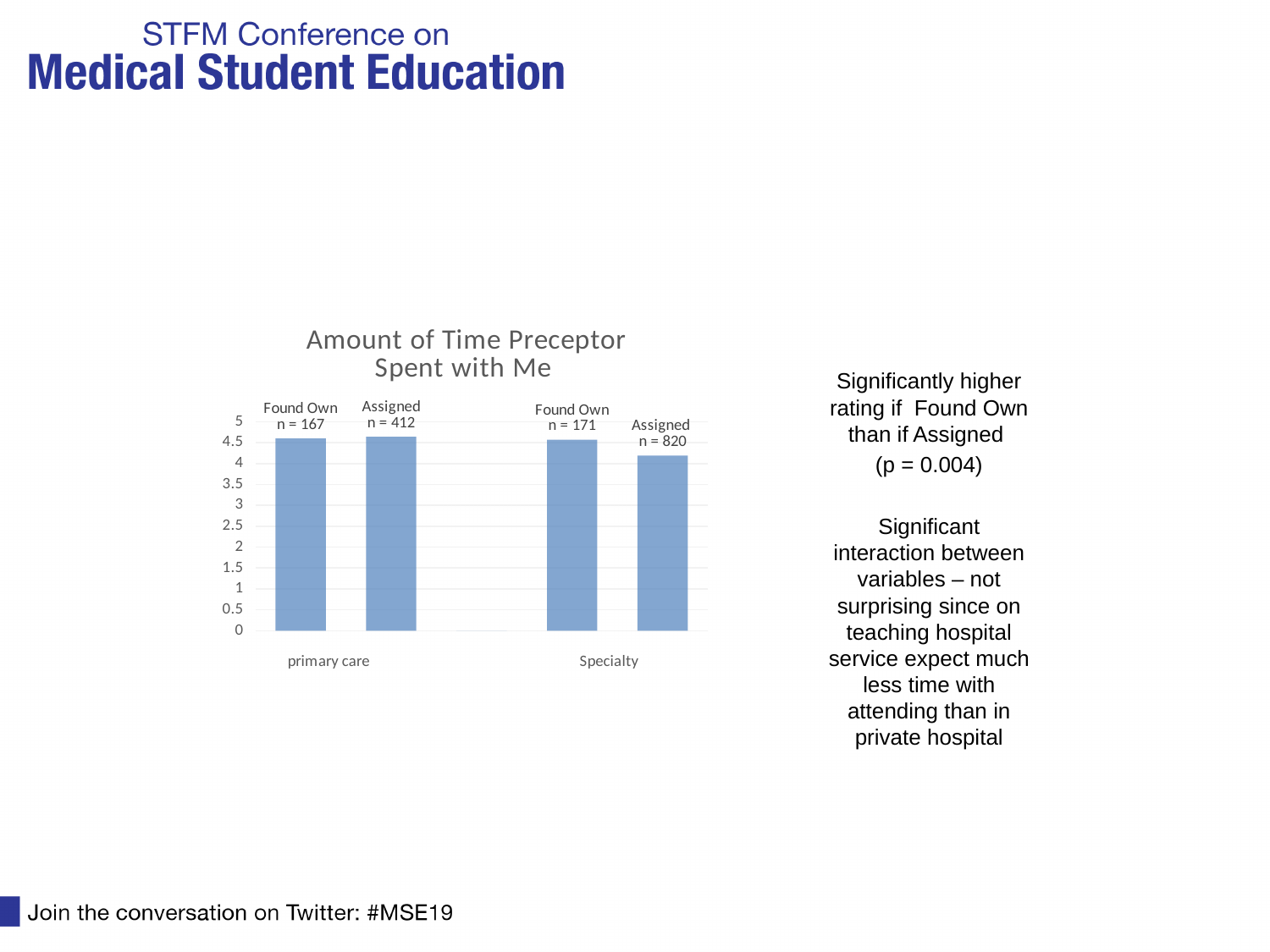
How many groups are labelled along the x axis of the chart? 2 Which is larger: the primary care Assigned bar or the Specialty Assigned bar? primary care Assigned What is the n value shown for the primary care Found Own bar? n = 167 Is the value for the Specialty Assigned bar greater or less than 4.5? less Which is larger: the Specialty Found Own bar or the Specialty Assigned bar? Specialty Found Own How many bars are plotted in the chart? 4 Which bar has the lowest value in the chart? Specialty Assigned What is the title of the chart? Amount of Time Preceptor Spent with Me Is the value for the Specialty Assigned bar greater or less than 4? greater What kind of chart is shown on the slide? bar chart What is the n value shown for the Specialty Assigned bar? n = 820